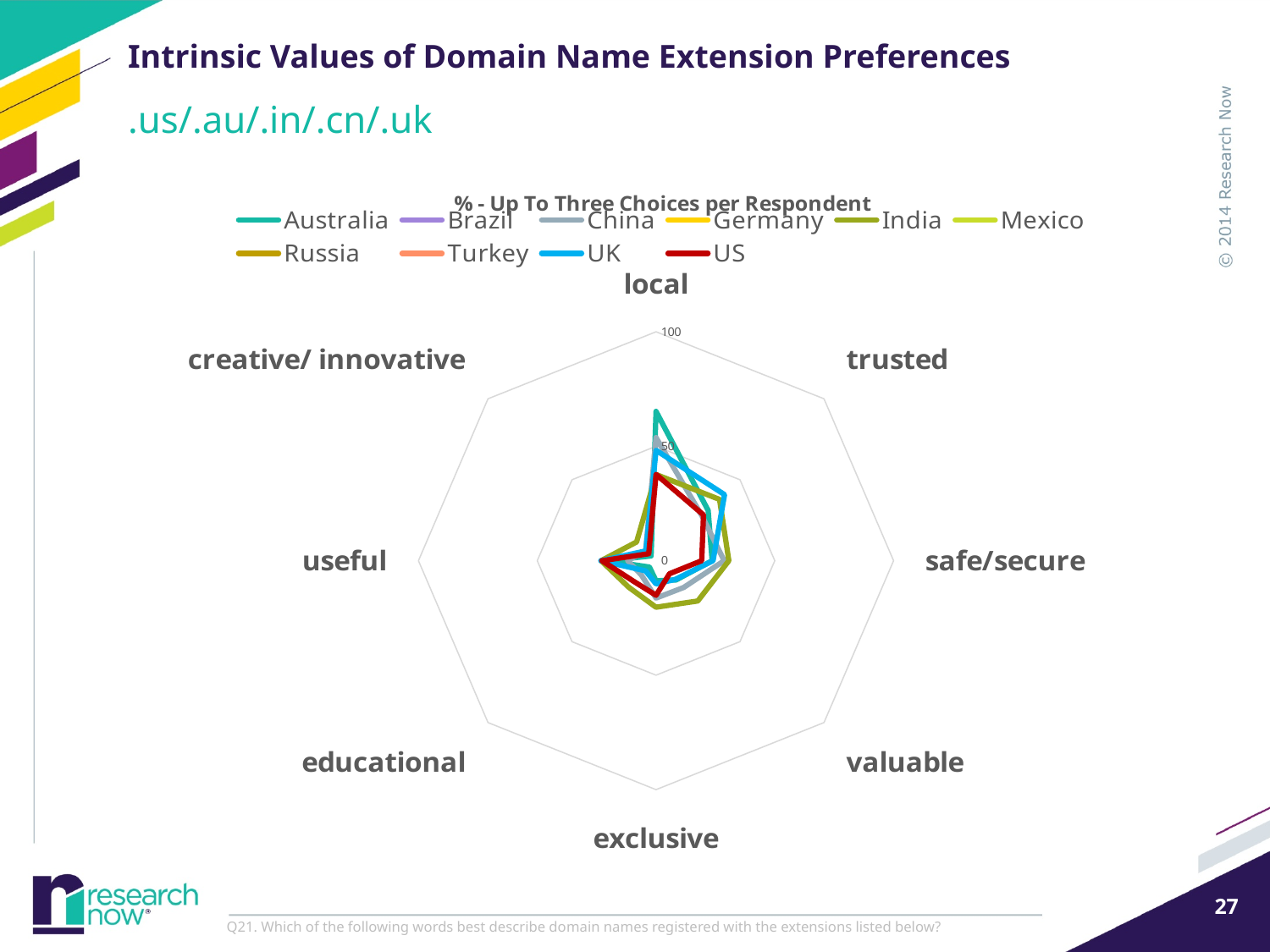
Is the value for US on the 'local' axis greater or less than 50? less Which series is drawn in red in the legend? US Is the value for Australia on the 'local' axis greater or less than 50? greater What kind of chart is shown on the slide? radar chart How many series does the legend list? 10 What is the highest value shown on the radar chart's axis scale? 100 How many categories (axes) does the radar chart have? 8 What is the title of the chart? % - Up To Three Choices per Respondent Which is larger: the Australia value or the US value on the 'local' axis? Australia On which axis does the US series reach its highest value? local On which axis does the Australia series reach its highest value? local Is the value for US on the 'educational' axis greater or less than 50? less